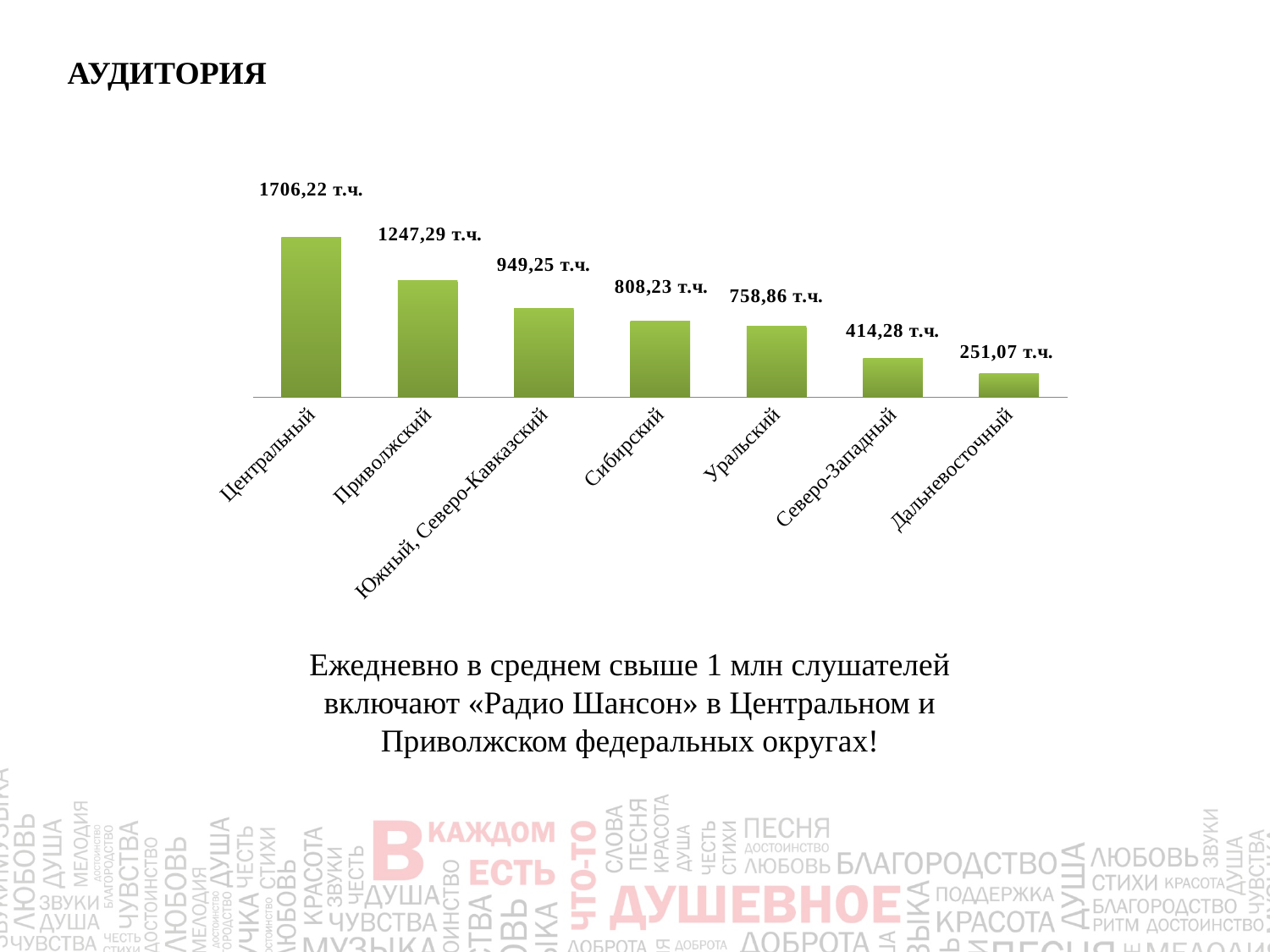
Which is larger, the value for Сибирский or the value for Уральский? Сибирский What kind of chart is shown on the slide? Bar chart Which category has the lowest value? Дальневосточный Do the values rise or fall from left to right along the x axis? Fall What is the value shown for Центральный? 1706,22 т.ч. What is the value shown for Дальневосточный? 251,07 т.ч. What is the difference between the values for Северо-Западный and Дальневосточный? 163,21 т.ч. What is the value shown for Южный, Северо-Кавказский? 949,25 т.ч. What is the difference between the values for Центральный and Приволжский? 458,93 т.ч. What is the value shown for Уральский? 758,86 т.ч. How many categories are shown in the chart? 7 Which category has the highest value? Центральный